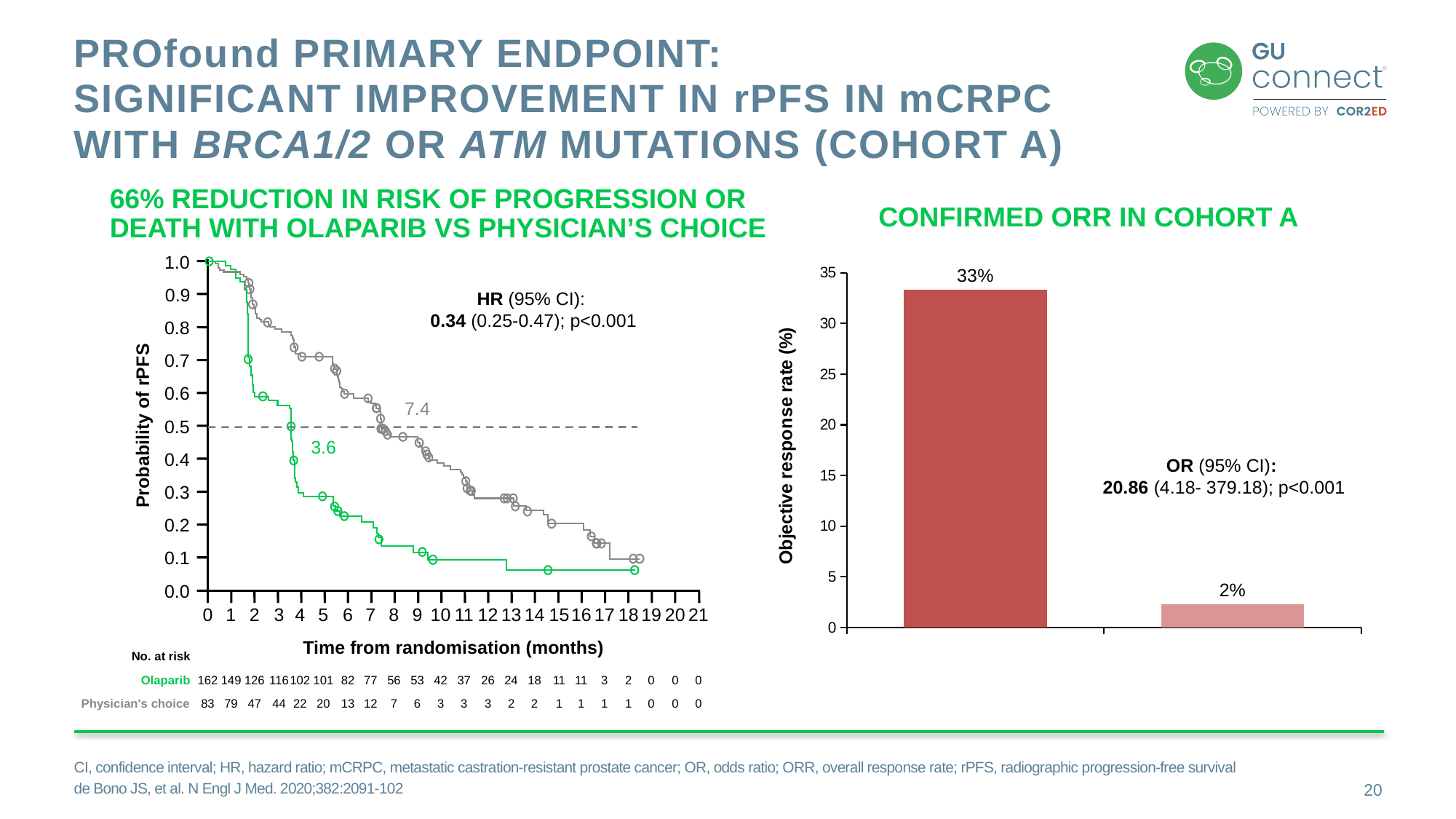
In the left Kaplan-Meier chart, what is the label of the x axis? Time from randomisation (months) What kind of chart is the 'Confirmed ORR in Cohort A' chart? bar chart In the left Kaplan-Meier chart, what is the number at risk for olaparib at month 0? 162 In the 'Confirmed ORR in Cohort A' chart, what is the value shown on the right (light pink) bar? 2% In the 'Confirmed ORR in Cohort A' chart, what is the value shown on the left (dark red) bar? 33% In the left Kaplan-Meier chart, what is the number at risk for physician's choice at month 0? 83 In the left Kaplan-Meier chart, what median value is labelled on the green (olaparib) curve? 3.6 In the left Kaplan-Meier chart, what median value is labelled on the grey (physician's choice) curve? 7.4 In the 'Confirmed ORR in Cohort A' chart, how many bars are plotted? 2 In the 'Confirmed ORR in Cohort A' chart, what is the difference between the two bar values? 31% In the 'Confirmed ORR in Cohort A' chart, which bar is taller, the left or the right? the left In the 'Confirmed ORR in Cohort A' chart, what is the label of the y axis? Objective response rate (%)